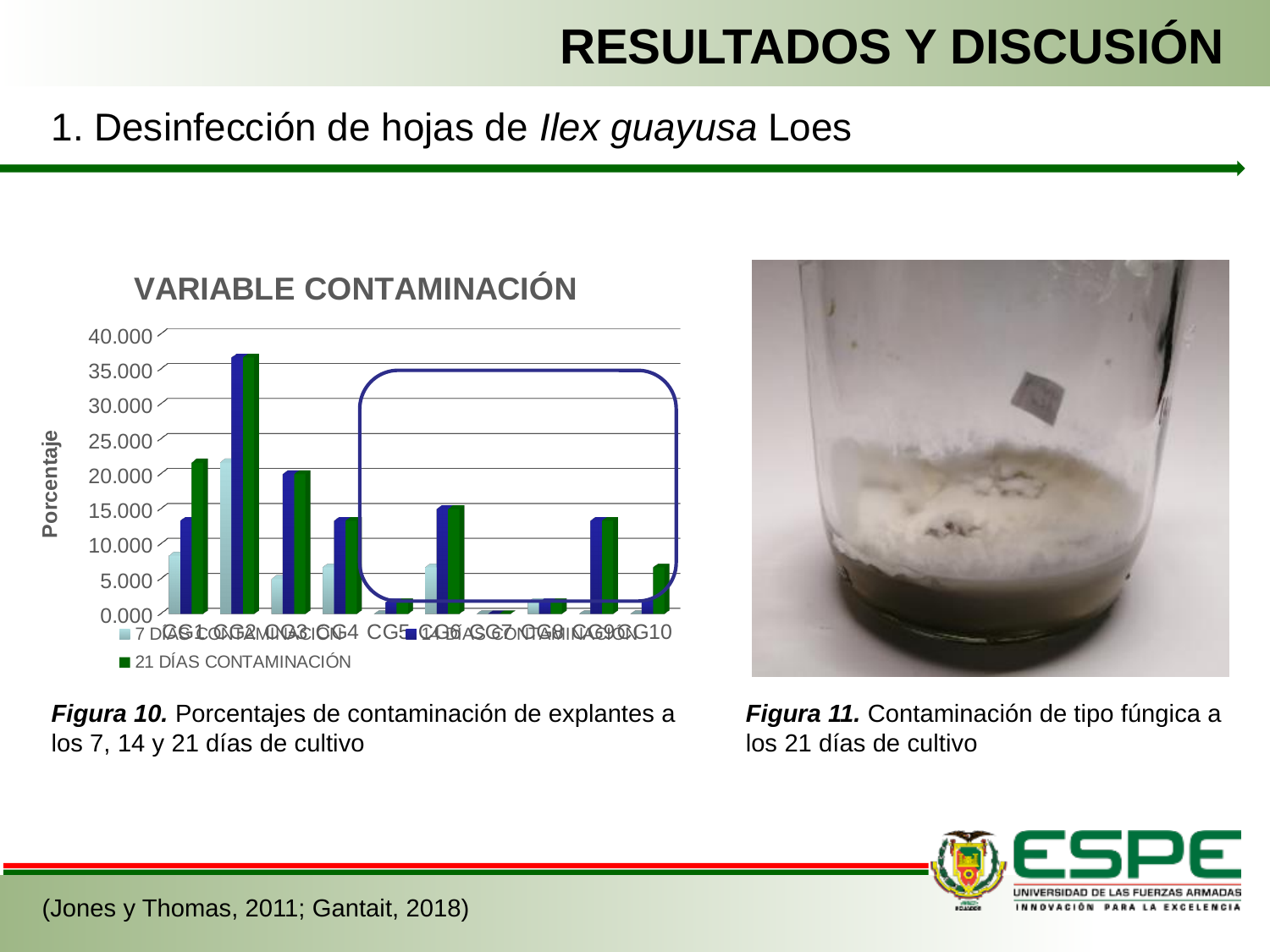
In the 'VARIABLE CONTAMINACIÓN' chart, is the value of '21 DÍAS CONTAMINACIÓN' for CG10 greater or less than 5.000? greater In the 'VARIABLE CONTAMINACIÓN' chart, for CG4, which is larger: the '7 DÍAS CONTAMINACIÓN' value or the '14 DÍAS CONTAMINACIÓN' value? 14 DÍAS CONTAMINACIÓN What is the label of the vertical axis of the 'VARIABLE CONTAMINACIÓN' chart? Porcentaje In the 'VARIABLE CONTAMINACIÓN' chart, for CG10, which is larger: the '14 DÍAS CONTAMINACIÓN' value or the '21 DÍAS CONTAMINACIÓN' value? 21 DÍAS CONTAMINACIÓN What kind of chart is shown under the title 'VARIABLE CONTAMINACIÓN'? bar chart In the 'VARIABLE CONTAMINACIÓN' chart, is the value of '21 DÍAS CONTAMINACIÓN' for CG5 greater or less than 5.000? less In the 'VARIABLE CONTAMINACIÓN' chart, is the value of '14 DÍAS CONTAMINACIÓN' for CG4 greater or less than 10.000? greater How many series does the legend of the 'VARIABLE CONTAMINACIÓN' chart list? 3 How many categories (CG groups) are plotted along the x axis of the 'VARIABLE CONTAMINACIÓN' chart? 10 What is the title of the chart on the left of the slide? VARIABLE CONTAMINACIÓN